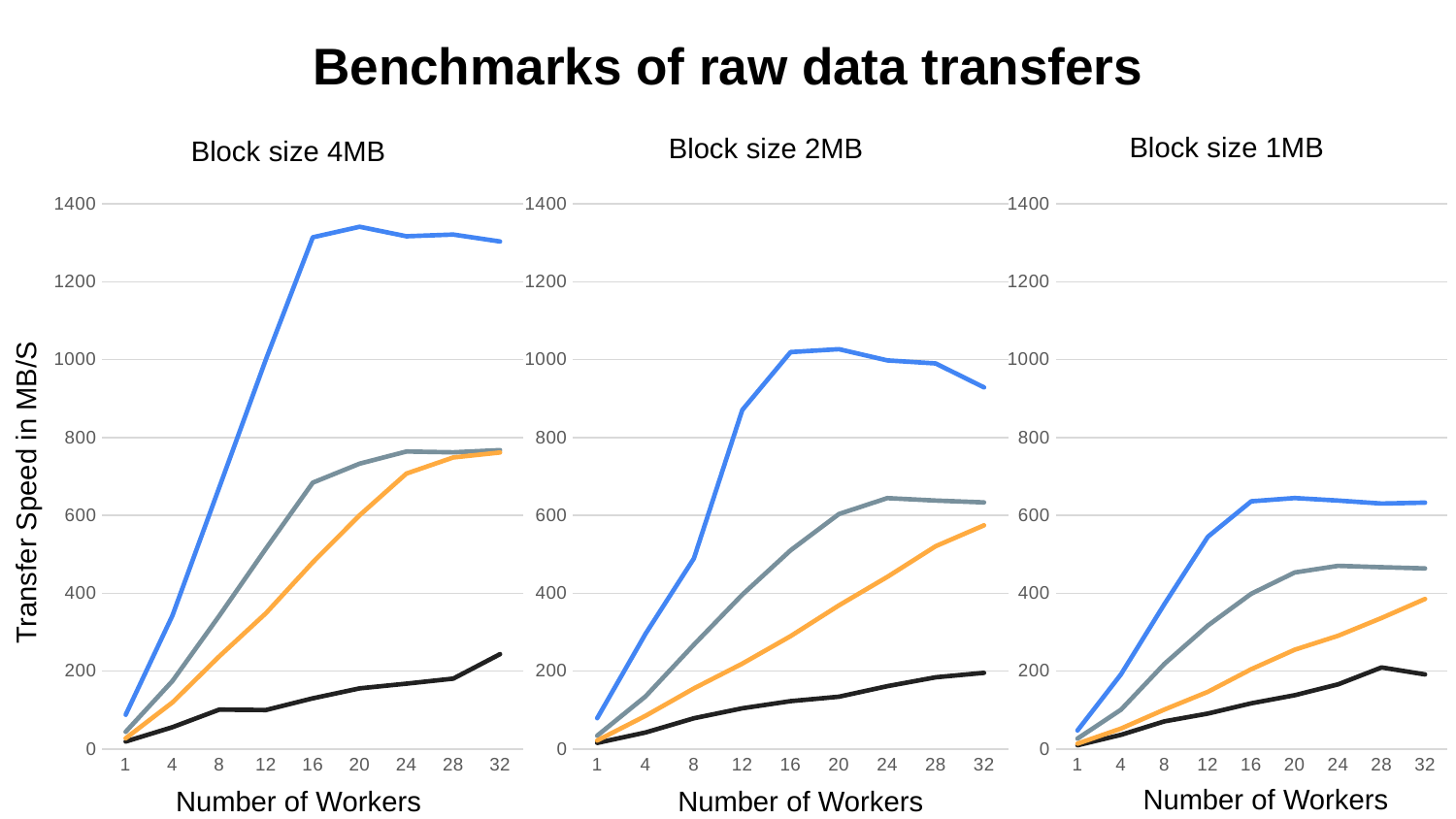
In the 'Block size 4MB' chart, is the value of the blue line at 32 workers greater or less than 1200? greater In the 'Block size 2MB' chart, how many worker counts are marked on the x axis? 9 In the 'Block size 4MB' chart, does the black line rise or fall as the number of workers increases from 1 to 32? rises In the 'Block size 2MB' chart, at 32 workers, which line is higher: the grey line or the orange line? the grey line In the 'Block size 4MB' chart, is the value of the orange line at 16 workers greater or less than 400? greater In the 'Block size 1MB' chart, is the value of the blue line at 16 workers greater or less than 600? greater Which chart reaches a higher peak value for its blue line: 'Block size 4MB' or 'Block size 2MB'? Block size 4MB How many charts are shown on the slide? 3 What kind of chart is the 'Block size 4MB' chart? line chart What is the title of the slide? Benchmarks of raw data transfers What is the label of the y axis? Transfer Speed in MB/S